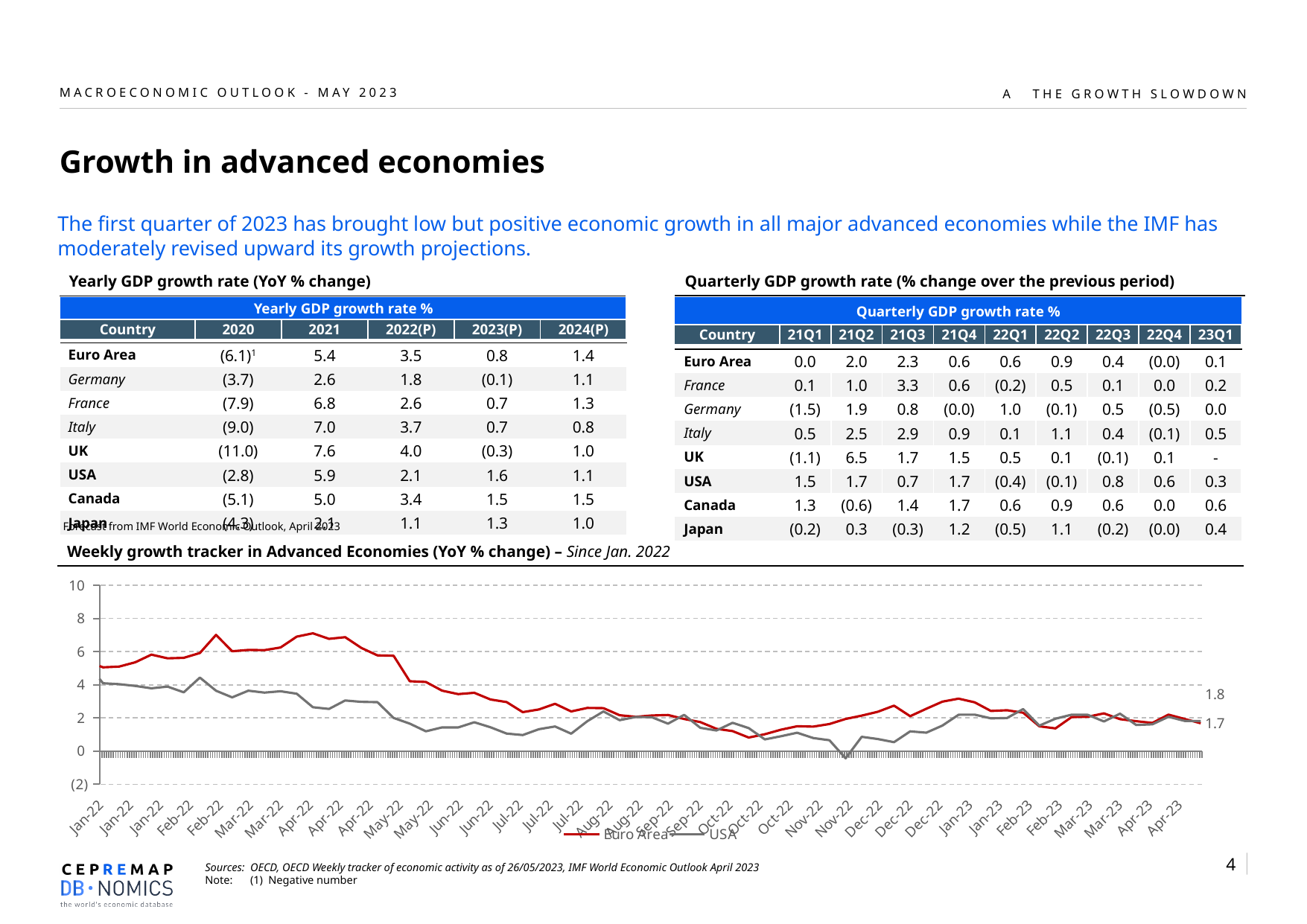
In the weekly growth tracker chart, which series reaches the highest value shown on the chart? Euro Area In the weekly growth tracker chart, what colour is the Euro Area line? Red In the weekly growth tracker chart, is the Euro Area peak around Apr-22 greater or less than 6? greater In the weekly growth tracker chart, what are the two data labels printed at the right end of the lines? 1.8 and 1.7 In the weekly growth tracker chart, is the USA value around Nov-22 greater or less than 2? less In the weekly growth tracker chart, which series is higher at the start of the chart in Jan-22, Euro Area or USA? Euro Area In the weekly growth tracker chart, is the USA value at the start of Jan-22 greater or less than 6? less In the weekly growth tracker chart, does the Euro Area line overall rise or fall from Jan-22 to Apr-23? Fall How many series does the legend of the weekly growth tracker chart list? 2 Which two series are shown in the legend of the weekly growth tracker chart? Euro Area and USA What kind of chart is the 'Weekly growth tracker in Advanced Economies' chart at the bottom of the slide? Line chart